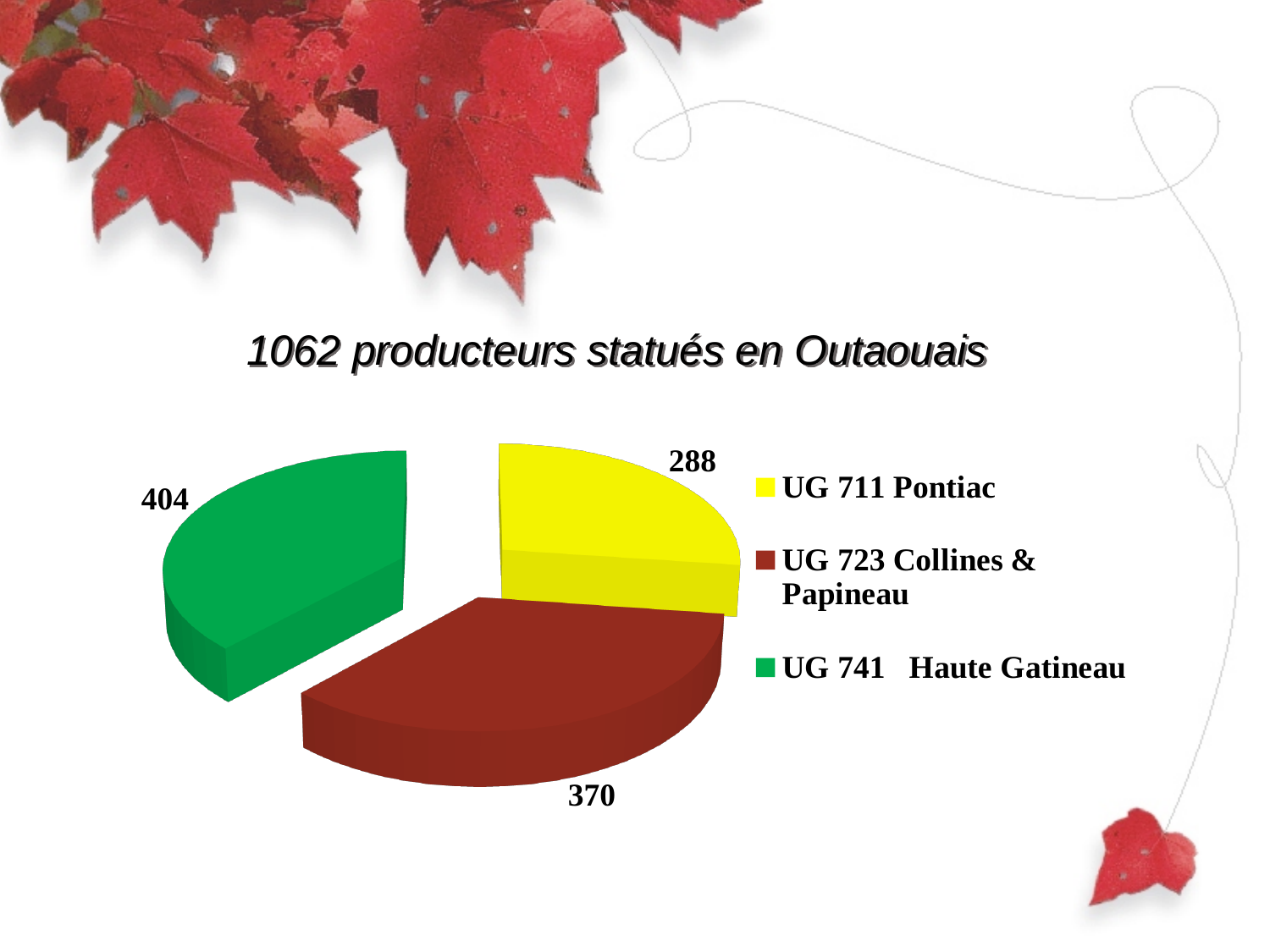
What is the value for UG 741 Haute Gatineau? 404 What is the total of all three slices in the pie chart? 1062 What is the difference between the values for UG 741 Haute Gatineau and UG 711 Pontiac? 116 Which category has the largest slice of the pie? UG 741 Haute Gatineau What kind of chart is shown on the slide? pie chart Which is larger, the value for UG 723 Collines & Papineau or the value for UG 741 Haute Gatineau? UG 741 Haute Gatineau What is the value for UG 711 Pontiac? 288 What is the difference between the values for UG 723 Collines & Papineau and UG 711 Pontiac? 82 Which category has the smallest slice of the pie? UG 711 Pontiac What is the title of the chart? 1062 producteurs statués en Outaouais How many slices does the pie chart have? 3 What is the value for UG 723 Collines & Papineau? 370